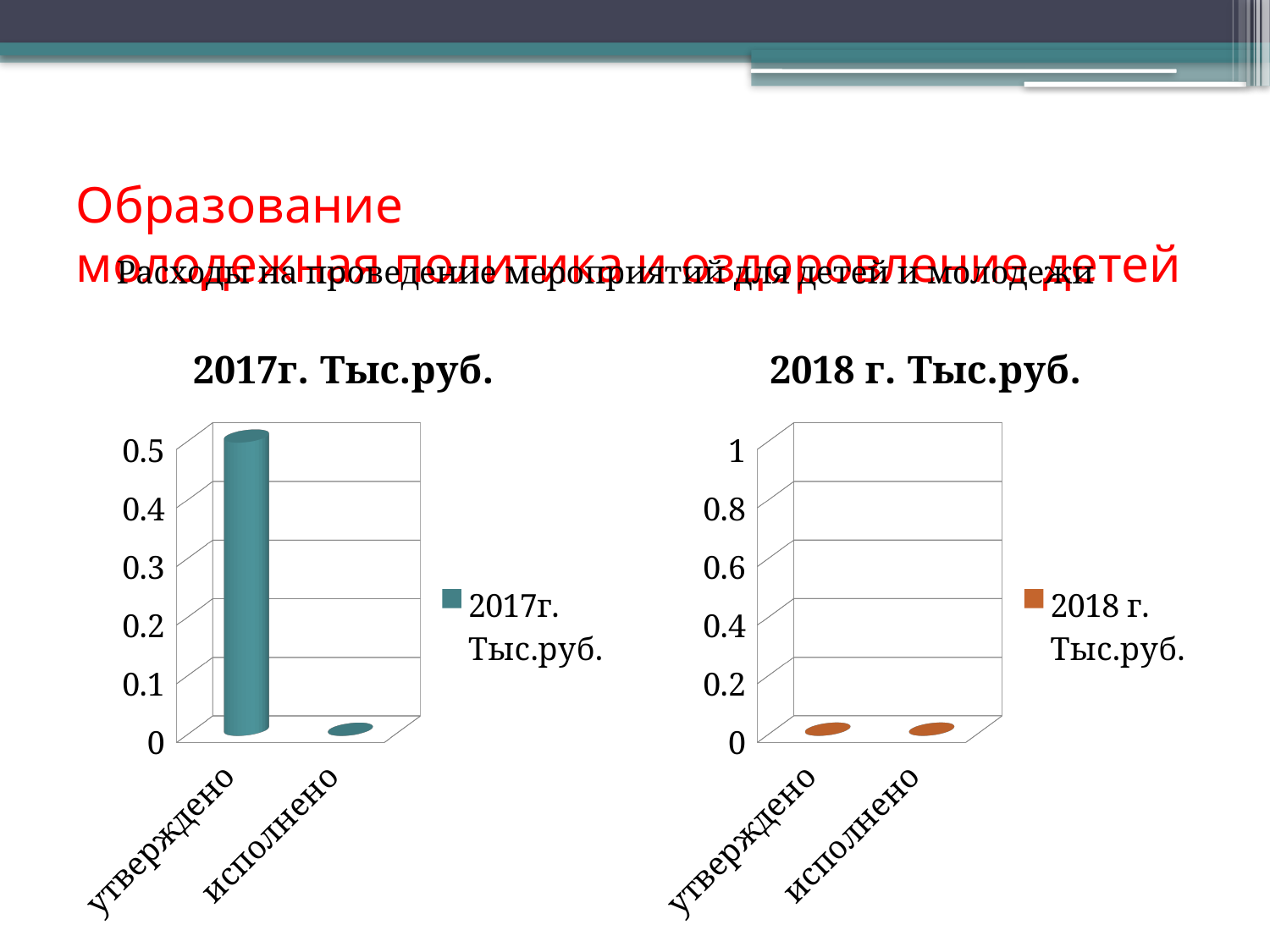
In the "2017г. Тыс.руб." chart, is the value for исполнено greater or less than 0.1? less What kind of chart is the "2017г. Тыс.руб." chart? bar chart How many series does the legend of the "2018 г. Тыс.руб." chart list? 1 In the "2017г. Тыс.руб." chart, which is larger: утверждено or исполнено? утверждено In the "2017г. Тыс.руб." chart, is the value for утверждено greater or less than 0.4? greater What is the title of the chart on the left? 2017г. Тыс.руб. In the "2017г. Тыс.руб." chart, which category has the highest value? утверждено In the "2017г. Тыс.руб." chart, do the values rise or fall from утверждено to исполнено? fall In the "2017г. Тыс.руб." chart, which category has the lowest value? исполнено What is the legend entry of the chart on the right? 2018 г. Тыс.руб. In the "2018 г. Тыс.руб." chart, is the value for утверждено greater or less than 0.2? less How many categories are shown on the x axis of the "2017г. Тыс.руб." chart? 2